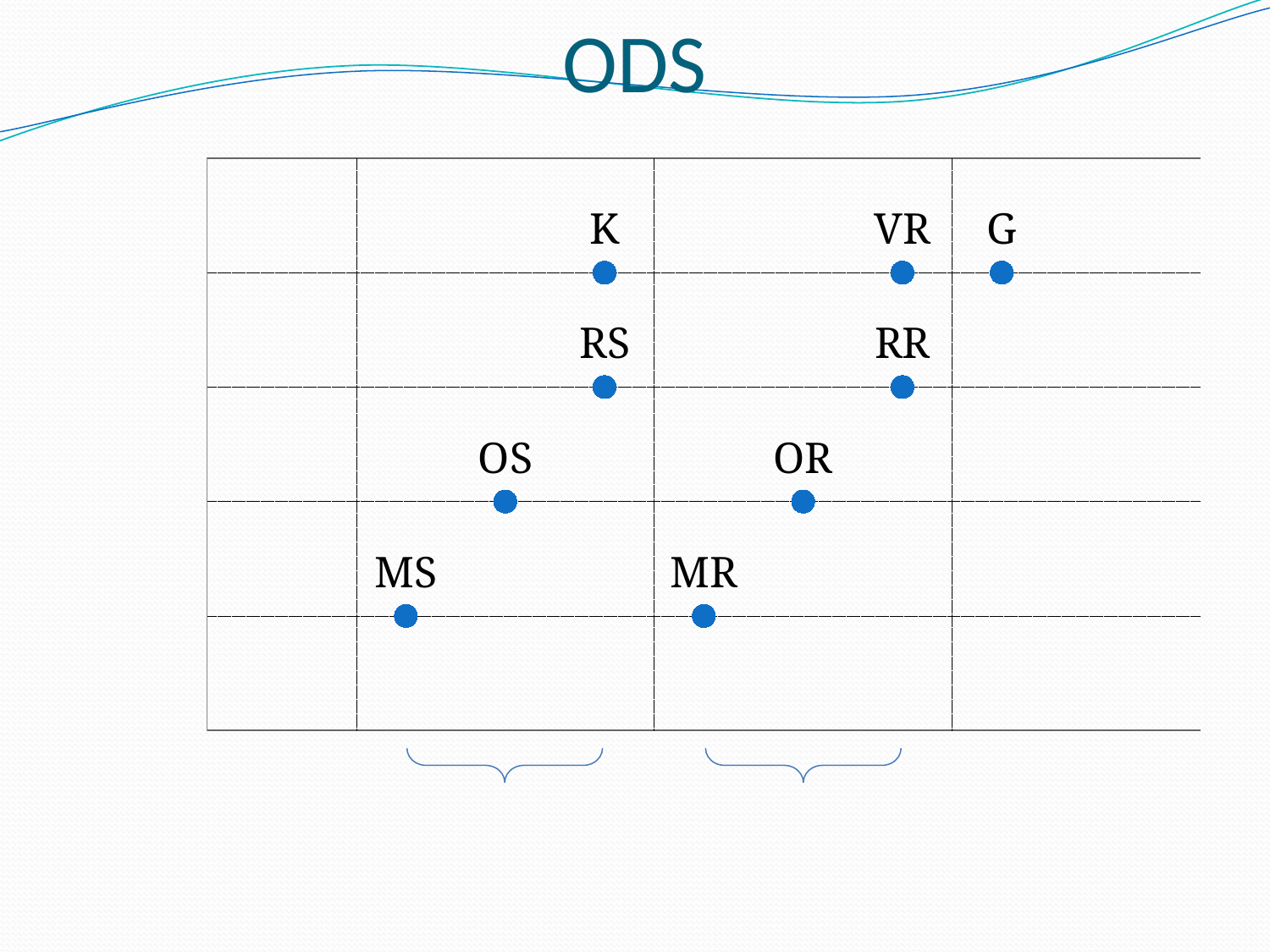
How many data points are plotted on the chart? 9 Which point is plotted higher on the chart, RR or OR? RR Which point is plotted furthest to the right on the chart? G What colour are the plotted points? blue Which point is plotted higher on the chart, OS or MS? OS Which point is plotted lower on the chart, MR or VR? MR What kind of chart is shown on the slide? scatter chart Which points share the topmost row of the chart? K, VR and G Which points share the bottommost row of the chart? MS and MR What is the title of the chart slide? ODS